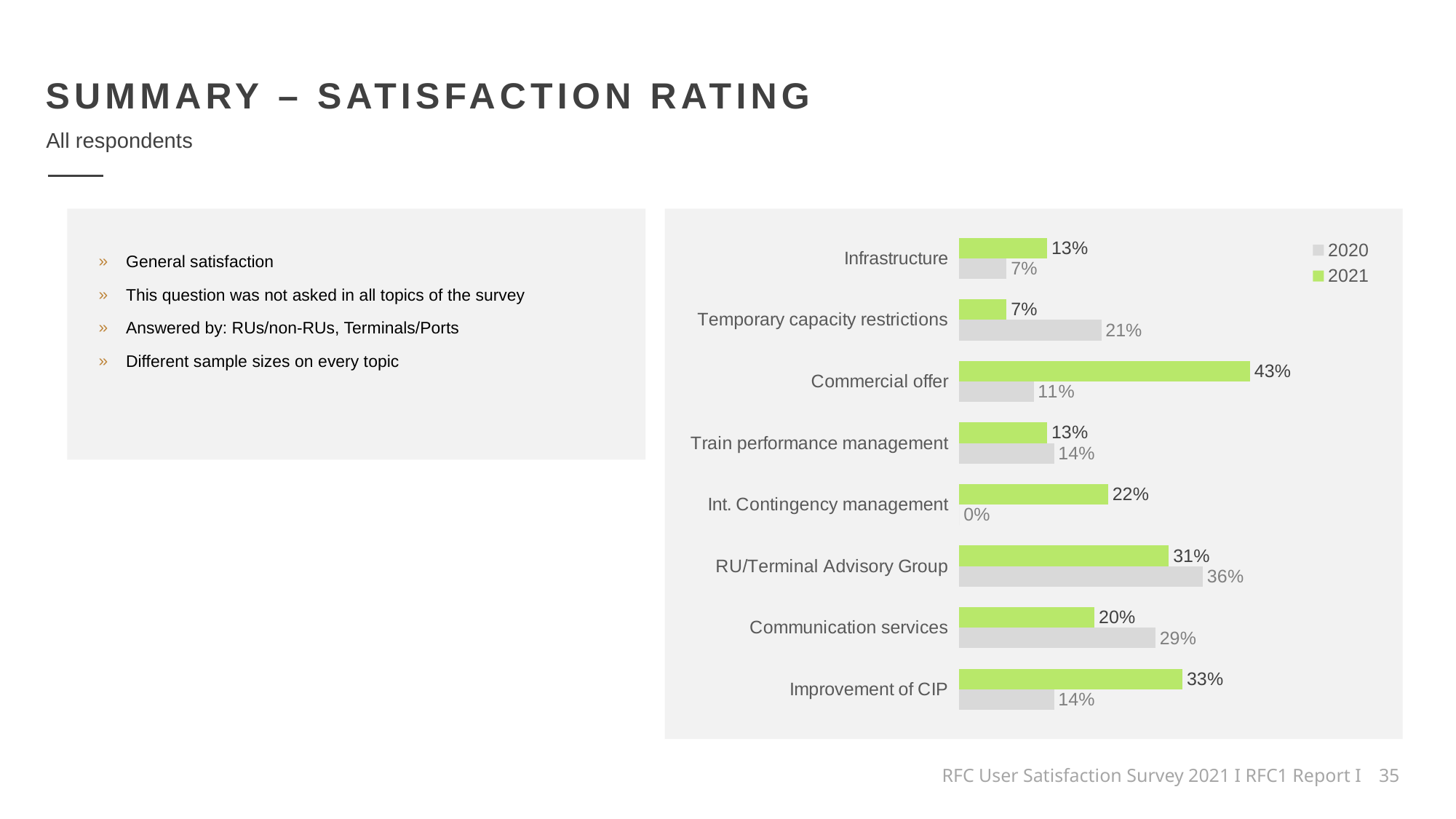
Which category has the highest 2021 value? Commercial offer Which is larger for RU/Terminal Advisory Group, the 2020 value or the 2021 value? 2020 What is the 2020 value for Temporary capacity restrictions? 21% How many categories are shown in the chart? 8 What is the 2020 value for Int. Contingency management? 0% Which category has the lowest 2020 value? Int. Contingency management Which colour represents the 2021 series in the chart? Green What is the difference between the 2021 and 2020 values for Commercial offer? 32% What is the 2021 value for Improvement of CIP? 33% How many series does the legend list? 2 What kind of chart is shown on the slide? Bar chart What is the 2021 value for Commercial offer? 43%